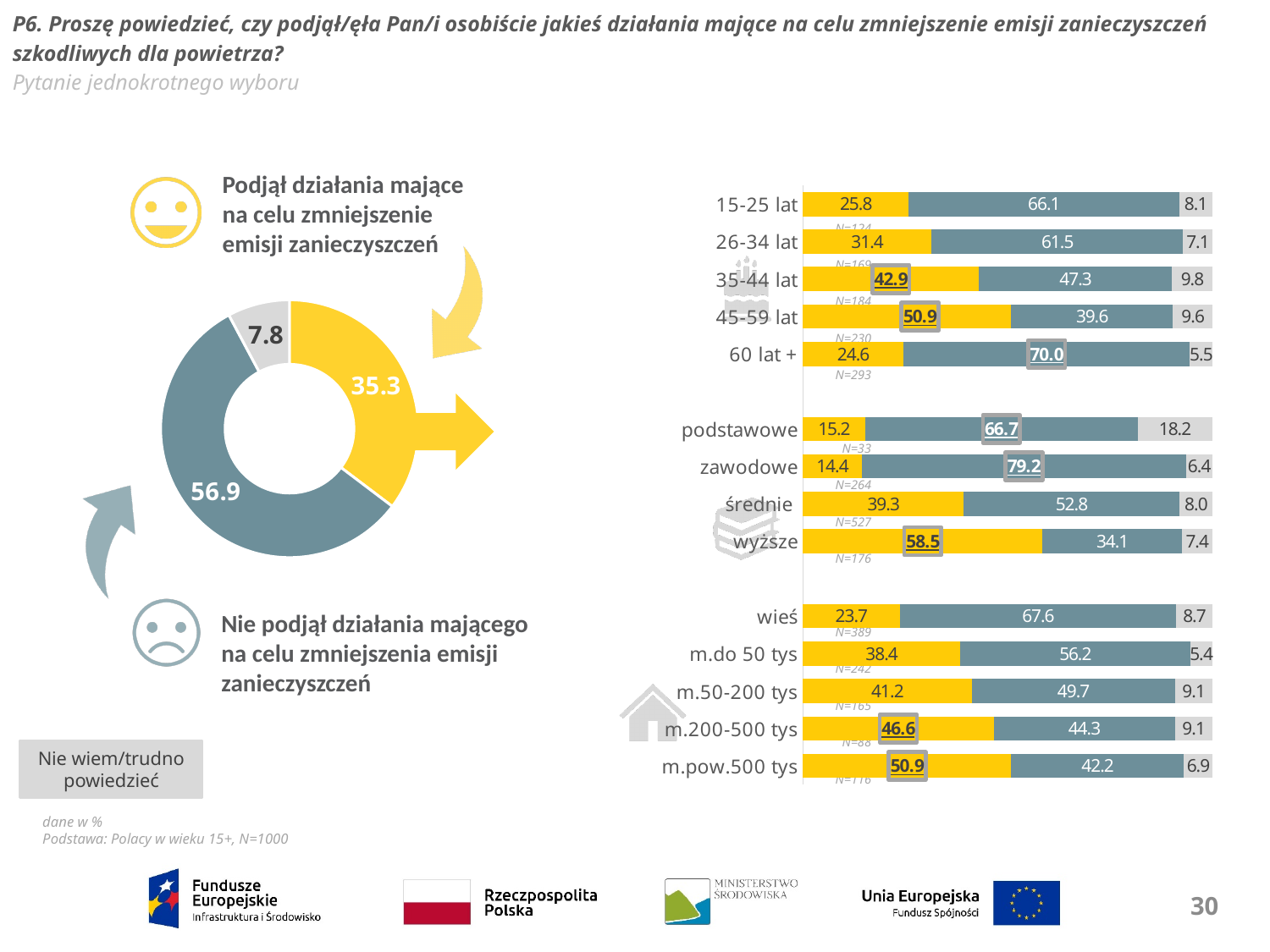
In the donut chart on the left, what is the difference between the share who did not take action and the share who did? 21.6 In the donut chart on the left, what share of respondents took action to reduce emissions of air pollutants? 35.3 What type of chart is shown on the left side of the slide? Donut chart In the bar chart on the right, what is the value of the light grey segment for 'podstawowe'? 18.2 How many categories (bars) are shown in the bar chart on the right? 14 In the bar chart on the right, what is the value of the yellow segment for 'wyższe'? 58.5 In the donut chart on the left, what share of respondents answered 'Nie wiem/trudno powiedzieć'? 7.8 In the donut chart on the left, which response has the largest share? Nie podjął działania mającego na celu zmniejszenia emisji zanieczyszczeń In the bar chart on the right, which age group has the highest yellow (took action) value? 45-59 lat In the bar chart on the right, what is the value of the grey-blue segment for 'zawodowe'? 79.2 In the bar chart on the right, which is larger: the yellow value for 'wieś' or for 'm.pow.500 tys'? m.pow.500 tys In the bar chart on the right, which education group has the lowest yellow (took action) value? zawodowe